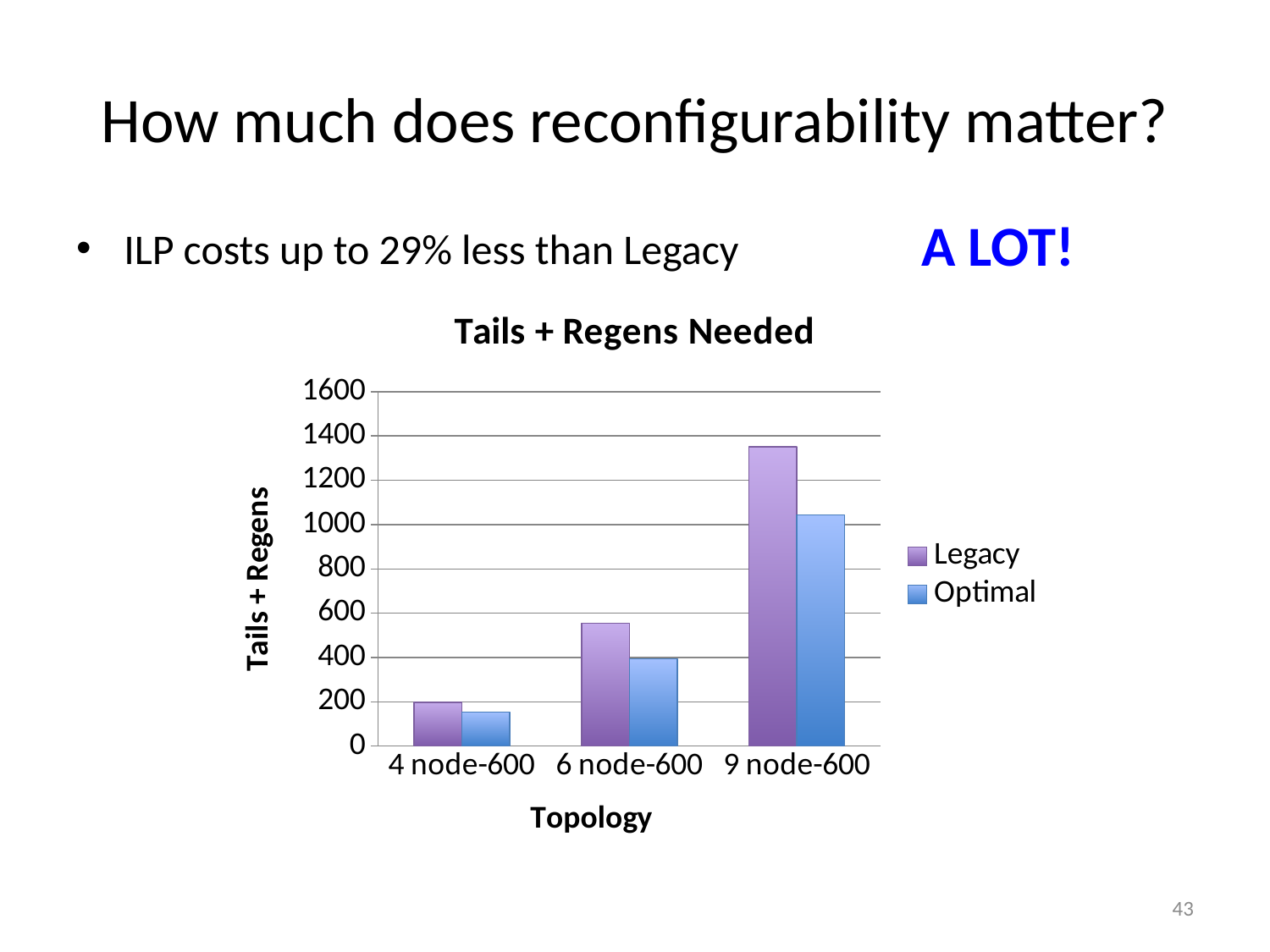
What is the label of the x axis? Topology Which topology has the highest Legacy value? 9 node-600 What is the title of the chart? Tails + Regens Needed For 9 node-600, which is larger, Legacy or Optimal? Legacy Is the Legacy value for 9 node-600 greater or less than 1200? greater How many topology categories are shown on the x axis? 3 What kind of chart is shown on the slide? bar chart Which topology has the lowest Optimal value? 4 node-600 Is the Optimal value for 6 node-600 greater or less than 600? less How many series does the legend list? 2 Do the Legacy values rise or fall from 4 node-600 to 9 node-600? rise